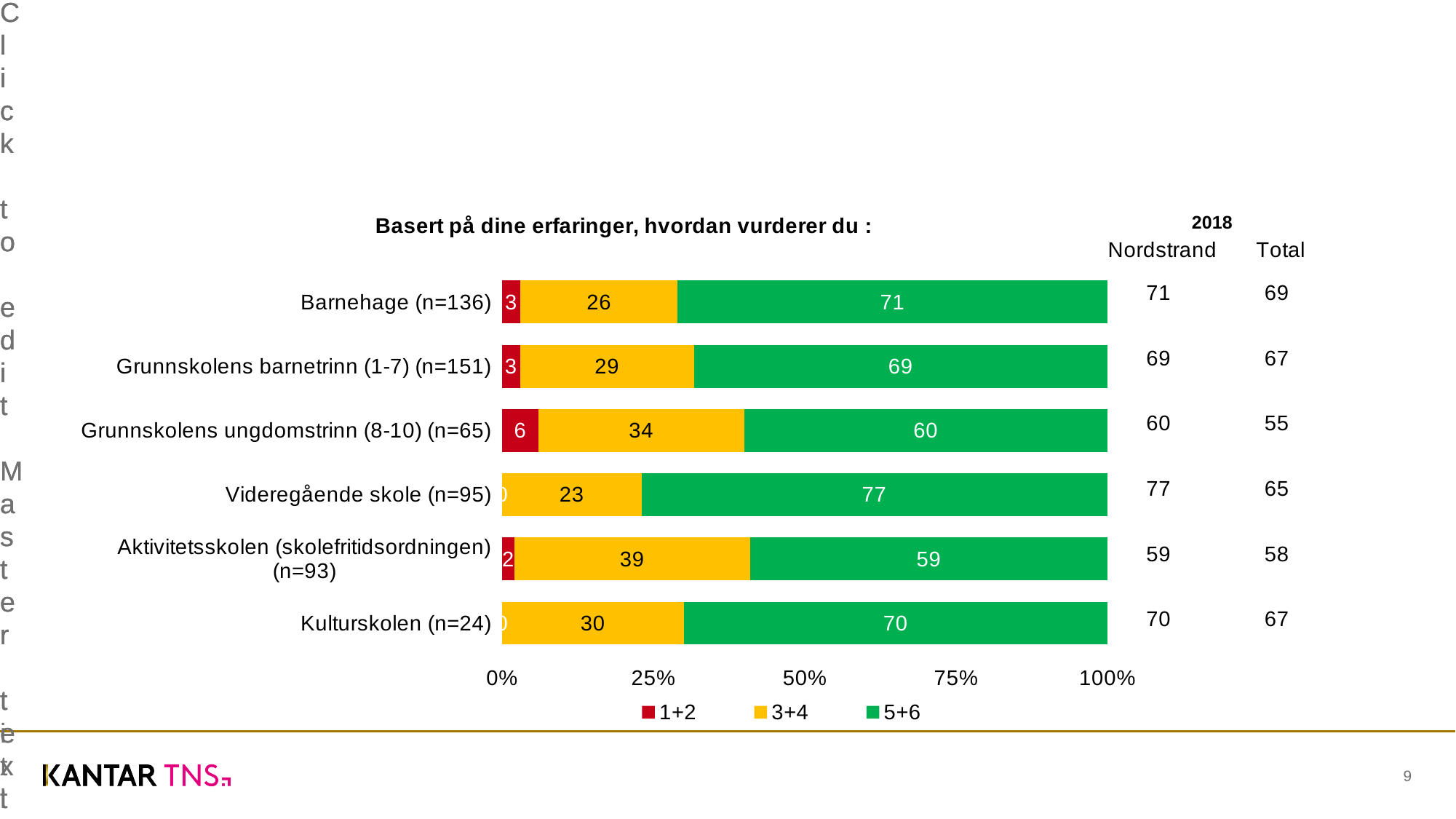
What is the value of the 3+4 segment for Aktivitetsskolen (skolefritidsordningen) (n=93)? 39 Which is larger: the 3+4 value for Grunnskolens ungdomstrinn (8-10) (n=65) or the 3+4 value for Barnehage (n=136)? Grunnskolens ungdomstrinn (8-10) (n=65) Which category has the lowest 5+6 value? Aktivitetsskolen (skolefritidsordningen) (n=93) What is the difference between the 5+6 value for Videregående skole (n=95) and the 5+6 value for Aktivitetsskolen (skolefritidsordningen) (n=93)? 18 Which category has the highest 3+4 value? Aktivitetsskolen (skolefritidsordningen) (n=93) What is the total of the stacked bar for Barnehage (n=136)? 100 Which category has the highest 5+6 value? Videregående skole (n=95) What is the value of the 5+6 segment for Barnehage (n=136)? 71 What is the value of the 1+2 segment for Grunnskolens ungdomstrinn (8-10) (n=65)? 6 How many series does the legend list? 3 What kind of chart is shown on the slide? Stacked bar chart How many categories are shown in the chart? 6